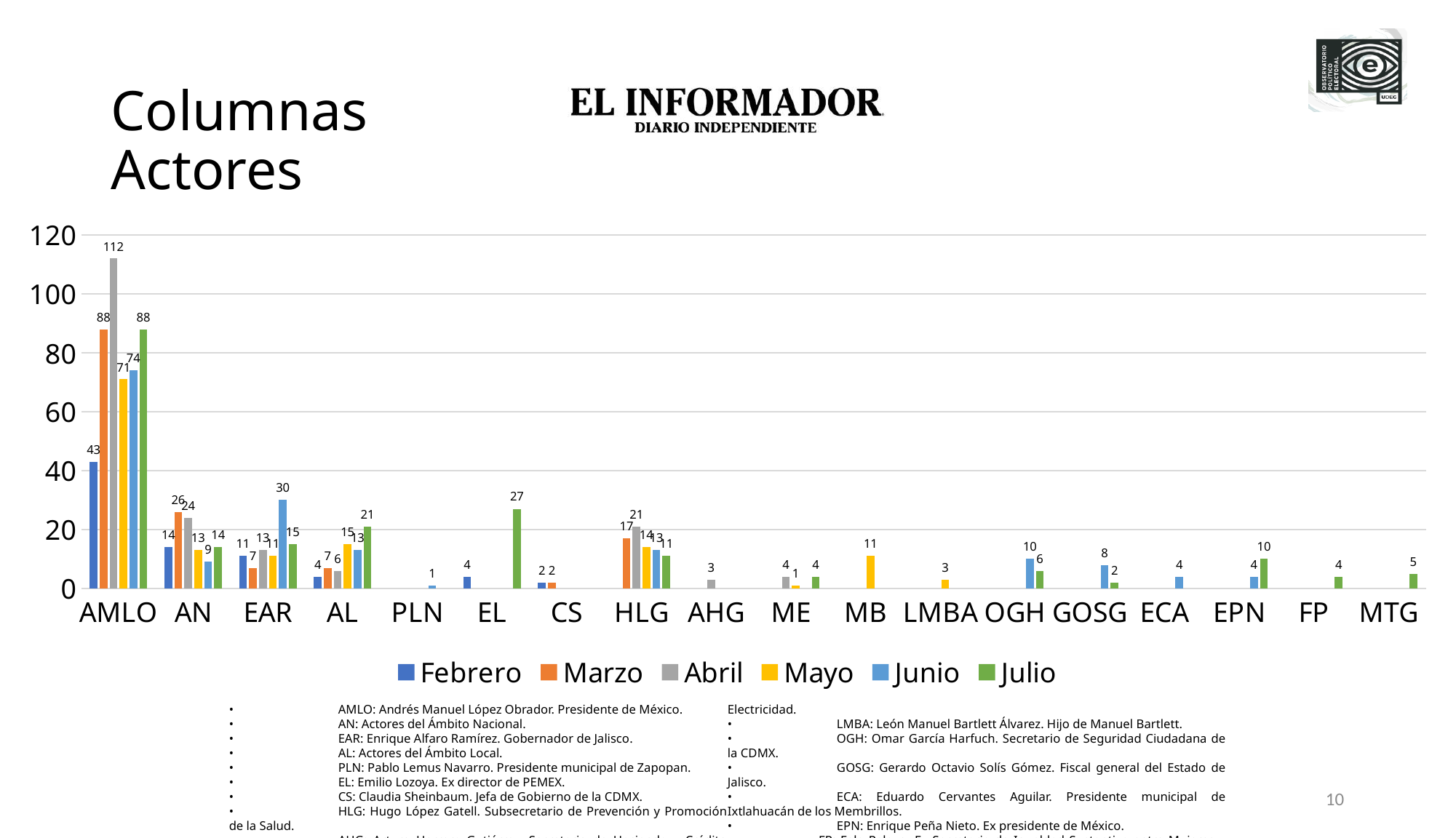
What is the value for HLG in Abril? 21 Which month has the lowest value for AL? Febrero What is the difference between the Abril and Febrero values for AMLO? 69 What is the value for AMLO in Abril? 112 What is the value for EL in Julio? 27 How many series does the legend list? 6 How many categories are shown on the x axis? 18 Which month has the highest value for AMLO? Abril Which is larger for AN: the Marzo value or the Abril value? Marzo What kind of chart is shown on the slide? Bar chart Is the Julio value for AMLO greater or less than 80? greater What is the value for EAR in Junio? 30